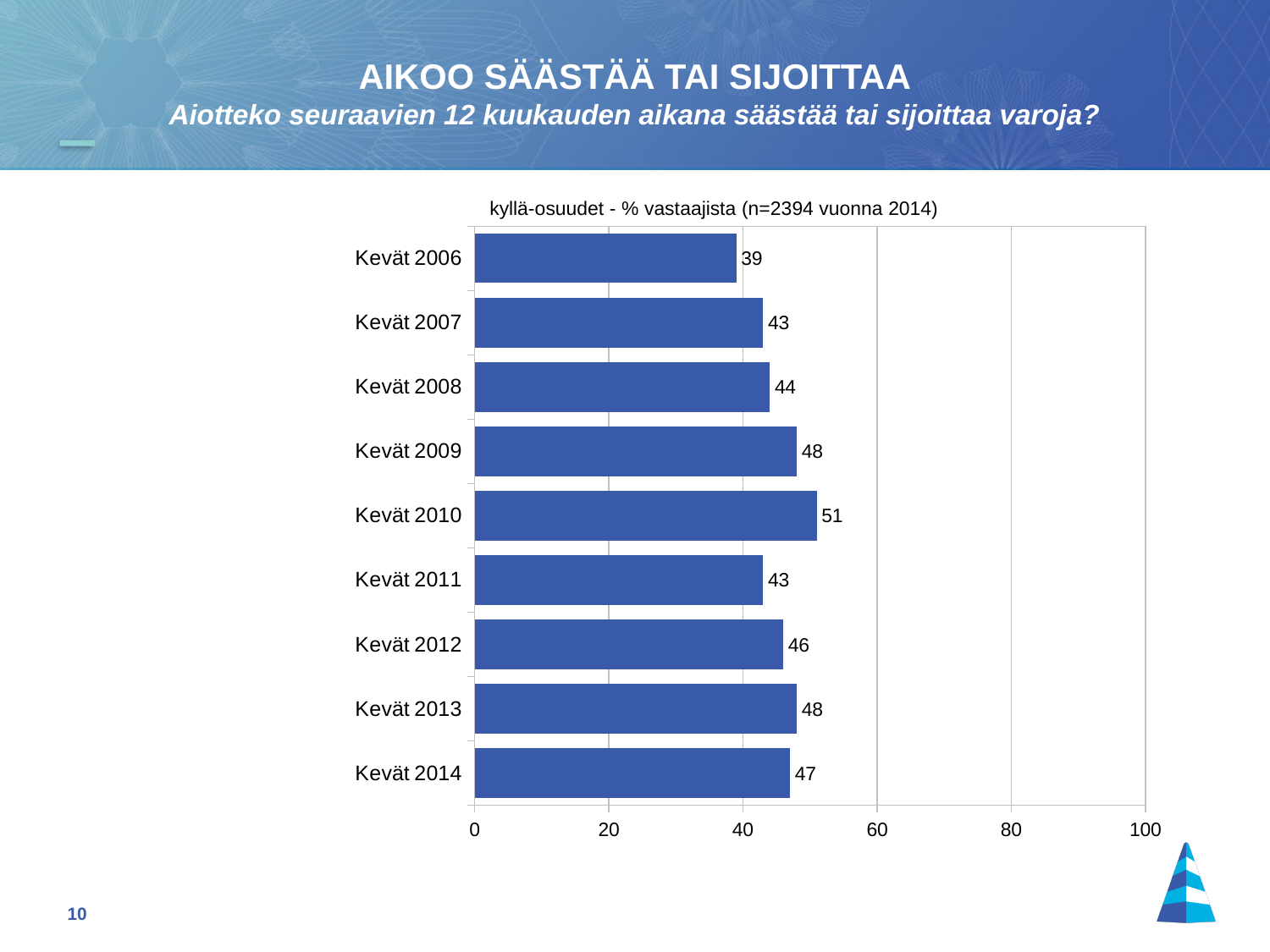
What is the difference between the values for Kevät 2010 and Kevät 2006? 12 What is the difference between the values for Kevät 2013 and Kevät 2014? 1 Which category has the highest value? Kevät 2010 Which category has the lowest value? Kevät 2006 What is the chart's title? kyllä-osuudet - % vastaajista (n=2394 vuonna 2014) How many categories are shown in the chart? 9 What is the value for Kevät 2014? 47 Which is larger, the value for Kevät 2012 or the value for Kevät 2013? Kevät 2013 What kind of chart is shown on the slide? bar chart What is the value for Kevät 2006? 39 What is the value for Kevät 2010? 51 Is the value for Kevät 2009 greater or less than 40? greater